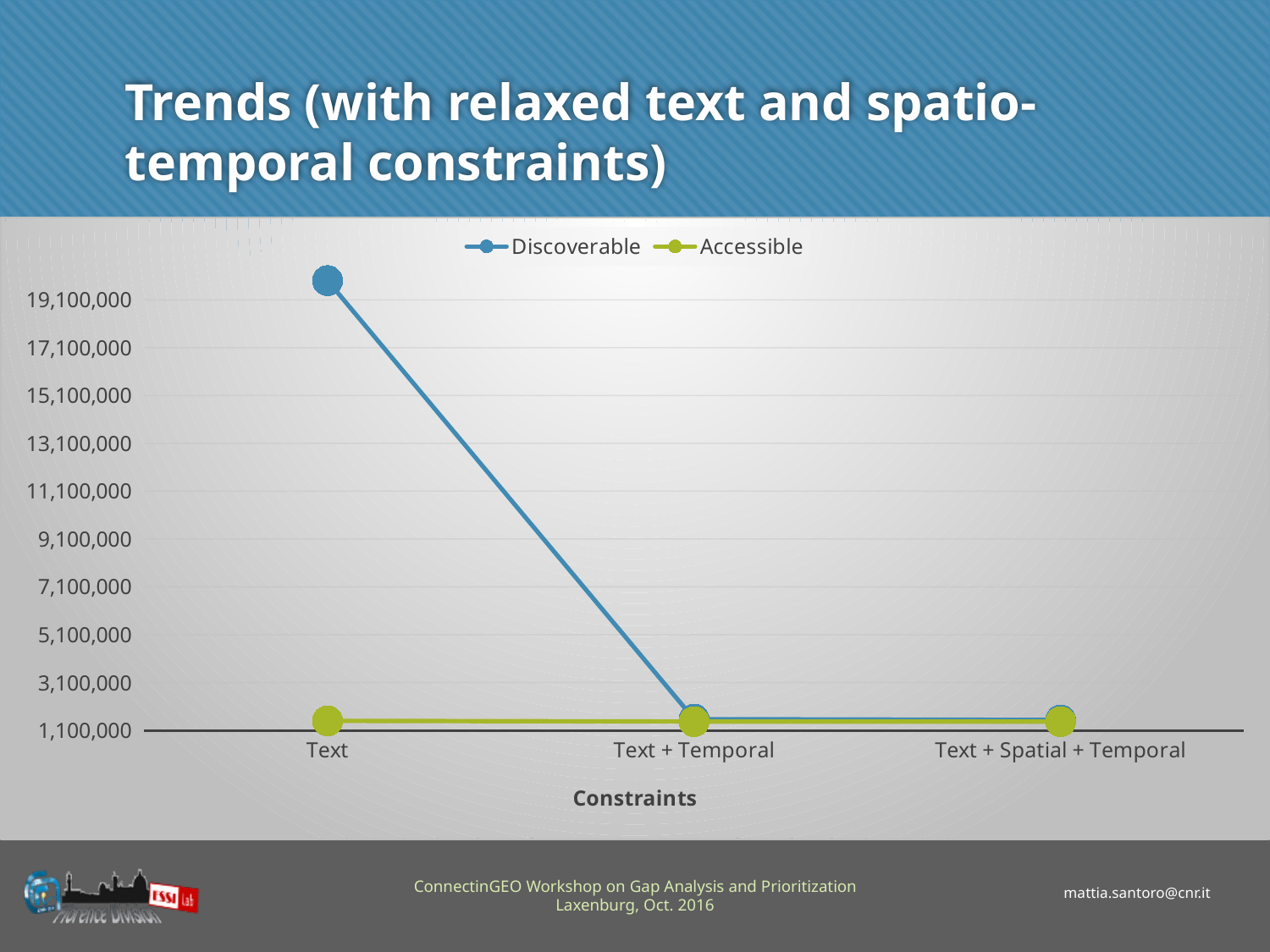
How many categories are shown on the x axis? 3 How many series does the legend list? 2 Does the Discoverable series rise or fall from Text to Text + Temporal? fall What is the title of the x axis? Constraints Is the Discoverable value for Text greater or less than 17,100,000? greater What kind of chart is shown on the slide? line chart Is the Accessible value for Text greater or less than 5,100,000? less Which series is drawn in green? Accessible Which is larger for the Text constraint, the Discoverable value or the Accessible value? Discoverable For which constraint is the Discoverable value highest? Text Is the Discoverable value for Text + Temporal greater or less than 3,100,000? less